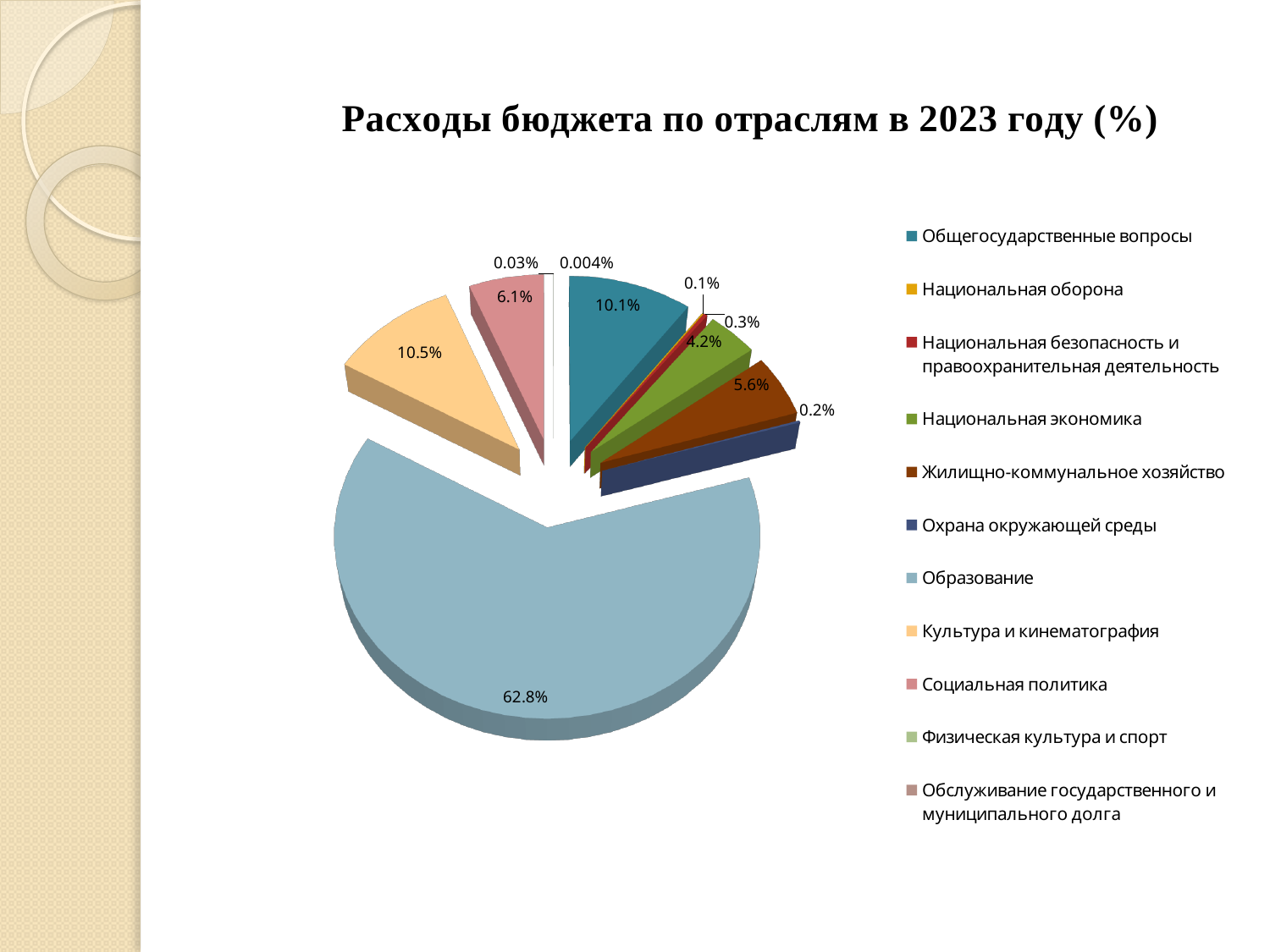
What is the title of the chart? Расходы бюджета по отраслям в 2023 году (%) What share of the budget goes to Общегосударственные вопросы? 10.1% What share of the budget goes to Жилищно-коммунальное хозяйство? 5.6% Which category has the largest share of the budget? Образование What share of the budget goes to Образование? 62.8% What kind of chart is shown on the slide? pie chart How many categories does the legend list? 11 What is the difference between the shares for Культура и кинематография and Общегосударственные вопросы? 0.4% Which category has the smallest share of the budget? Обслуживание государственного и муниципального долга What share of the budget goes to Социальная политика? 6.1% Which is larger, the share for Национальная экономика or the share for Жилищно-коммунальное хозяйство? Жилищно-коммунальное хозяйство What share of the budget goes to Культура и кинематография? 10.5%